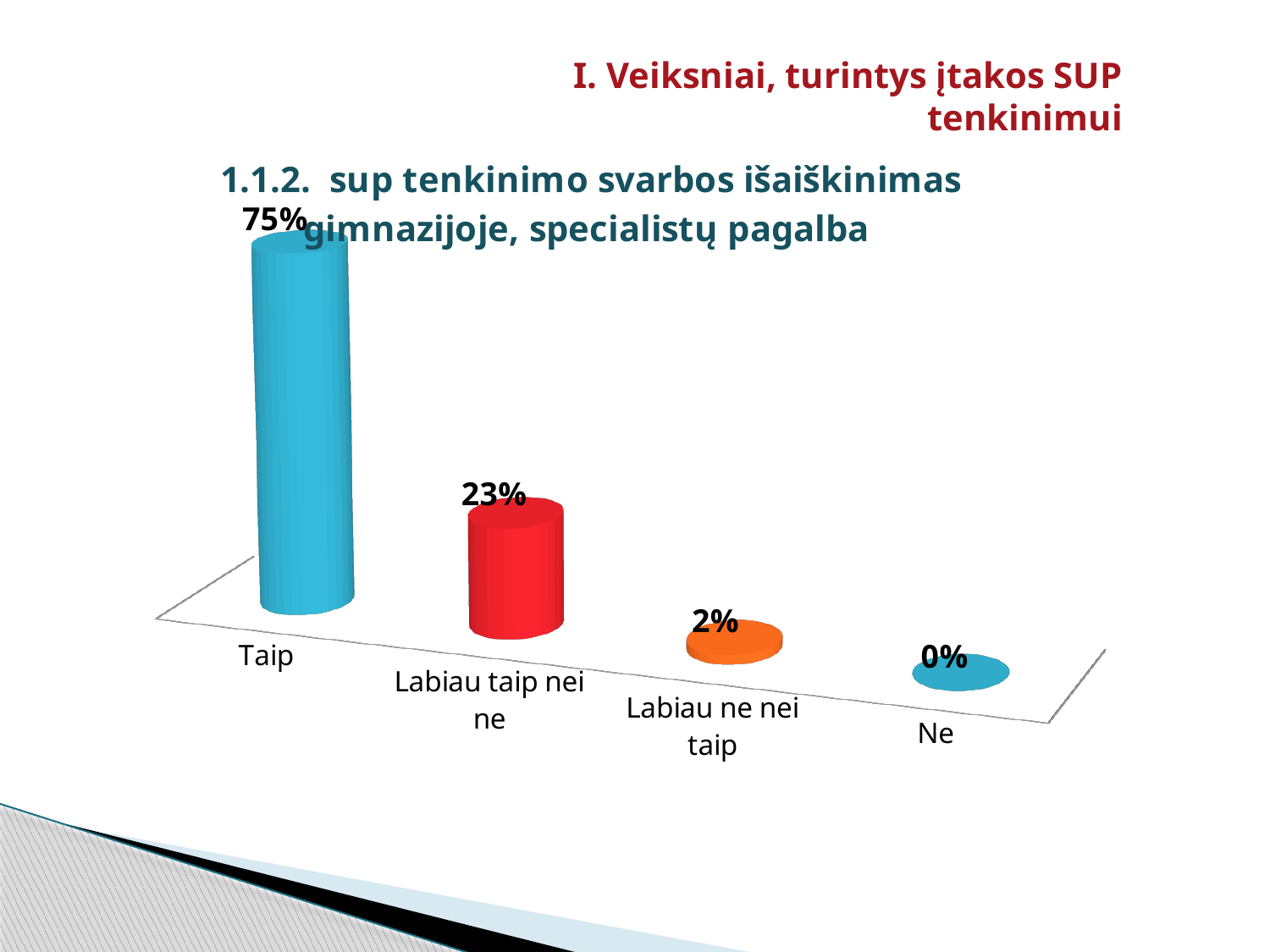
What is the value for "Ne"? 0% Which category has the lowest value? Ne Which is larger, the value for "Labiau taip nei ne" or the value for "Labiau ne nei taip"? Labiau taip nei ne What kind of chart is shown on the slide? bar chart What is the value for "Taip"? 75% Which category has the highest value? Taip What is the difference between the values for "Labiau taip nei ne" and "Labiau ne nei taip"? 21% How many categories are shown in the chart? 4 What is the value for "Labiau ne nei taip"? 2% What is the value for "Labiau taip nei ne"? 23% Do the values rise or fall from left to right along the x axis? fall What is the difference between the values for "Taip" and "Labiau taip nei ne"? 52%